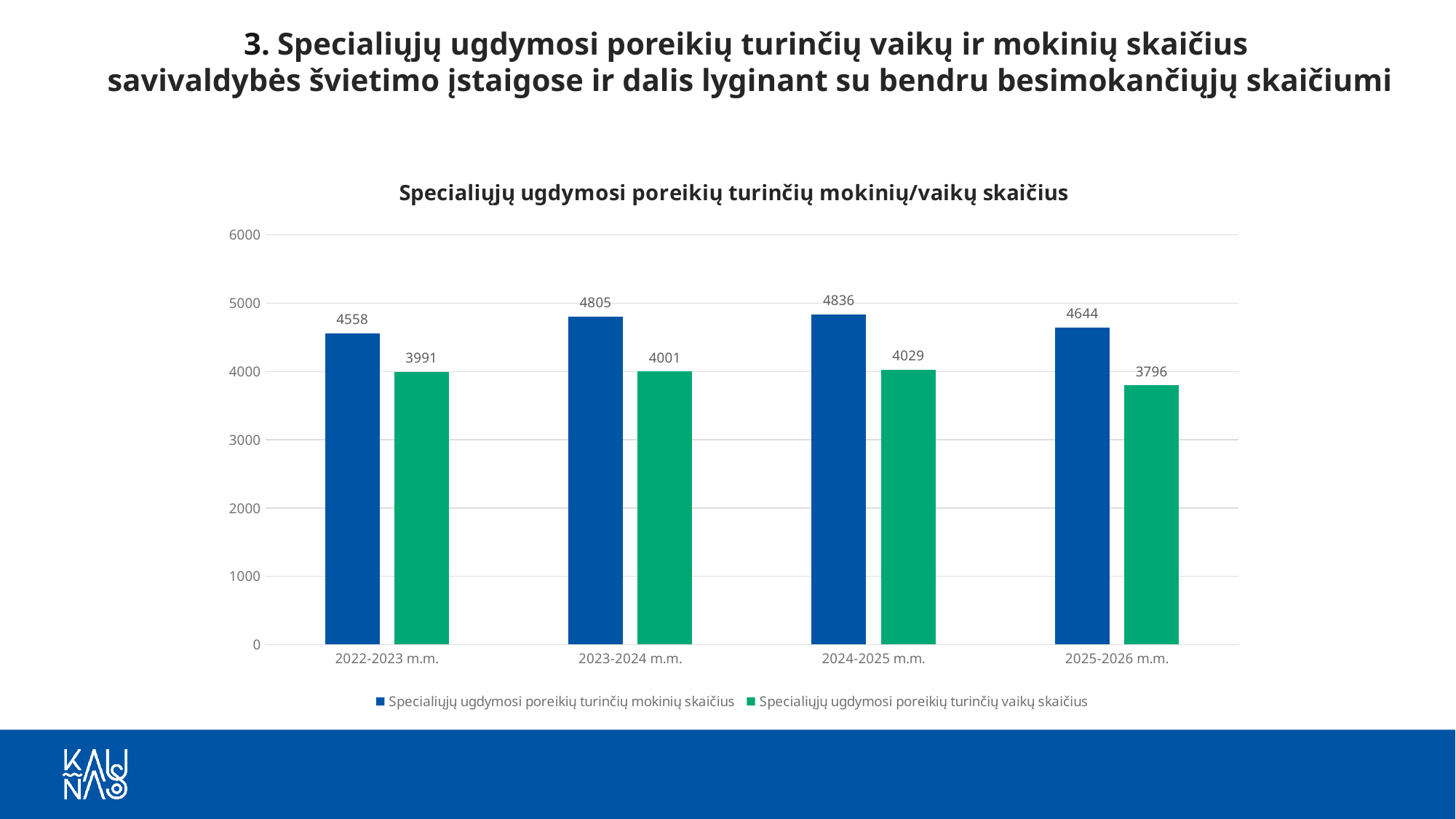
How many school years are shown on the x axis? 4 How many series does the legend list? 2 What is the value for 'Specialiųjų ugdymosi poreikių turinčių mokinių skaičius' in 2022-2023 m.m.? 4558 What is the value for 'Specialiųjų ugdymosi poreikių turinčių vaikų skaičius' in 2025-2026 m.m.? 3796 What is the difference between the mokinių skaičius and the vaikų skaičius in 2024-2025 m.m.? 807 What is the value for 'Specialiųjų ugdymosi poreikių turinčių vaikų skaičius' in 2023-2024 m.m.? 4001 What is the title of the chart? Specialiųjų ugdymosi poreikių turinčių mokinių/vaikų skaičius Which is larger: the vaikų skaičius in 2024-2025 m.m. or in 2025-2026 m.m.? 2024-2025 m.m. What kind of chart is shown on the slide? Bar chart What is the difference between the mokinių skaičius in 2023-2024 m.m. and in 2022-2023 m.m.? 247 In which school year is 'Specialiųjų ugdymosi poreikių turinčių vaikų skaičius' lowest? 2025-2026 m.m. In which school year is 'Specialiųjų ugdymosi poreikių turinčių mokinių skaičius' highest? 2024-2025 m.m.